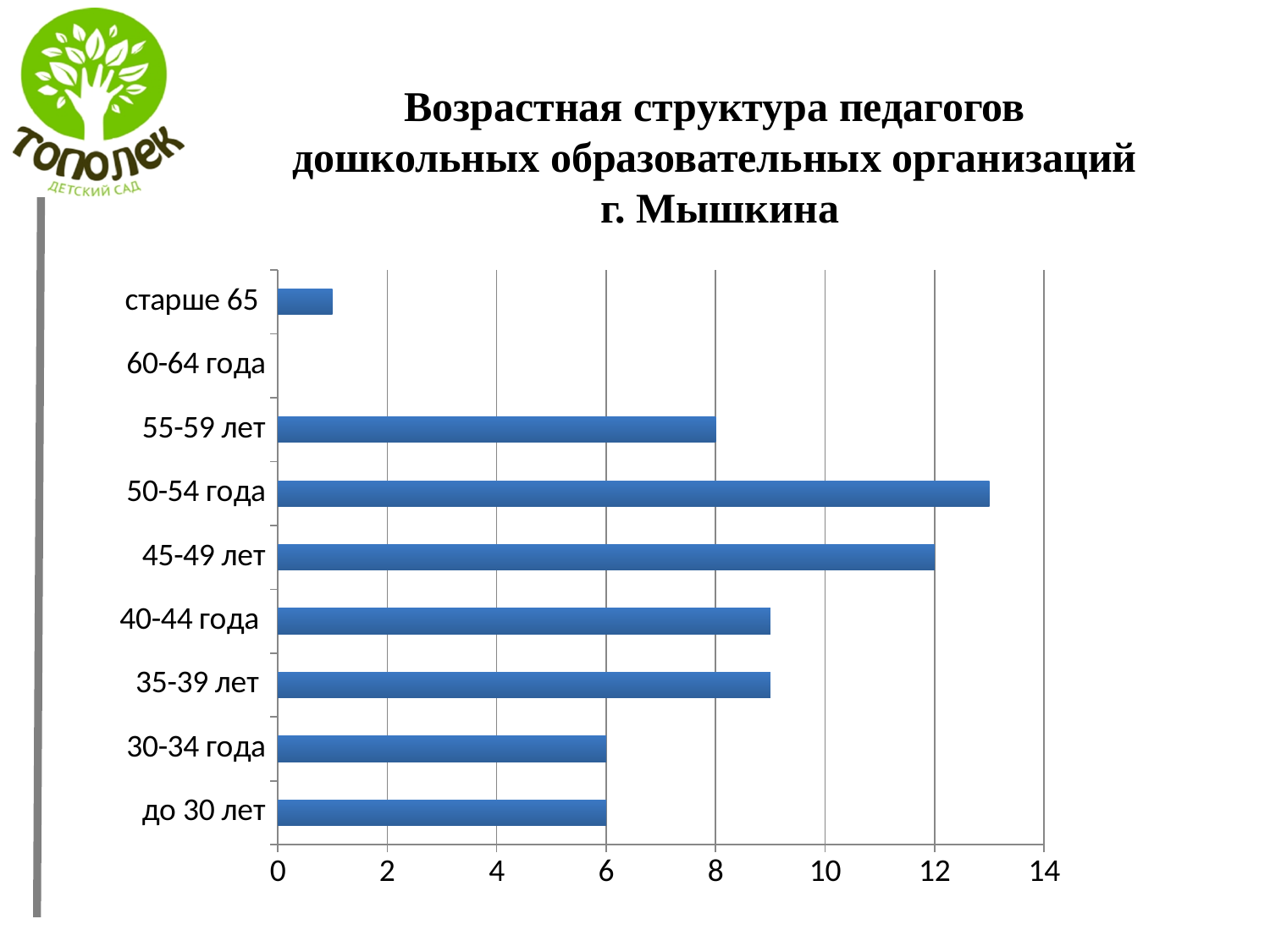
What is the value for the до 30 лет category? 6 Which age category has the highest value? 50-54 года Is the value for 50-54 года greater or less than 12? greater What is the difference between the values for 45-49 лет and 55-59 лет? 4 What is the value for the 30-34 года category? 6 Is the value for старше 65 greater or less than 2? less How many age categories are shown on the chart? 9 What is the value for the 55-59 лет category? 8 What is the value for the 45-49 лет category? 12 Which age category has the lowest value? 60-64 года Which is larger, the value for 40-44 года or the value for 30-34 года? 40-44 года What type of chart is shown on the slide? bar chart